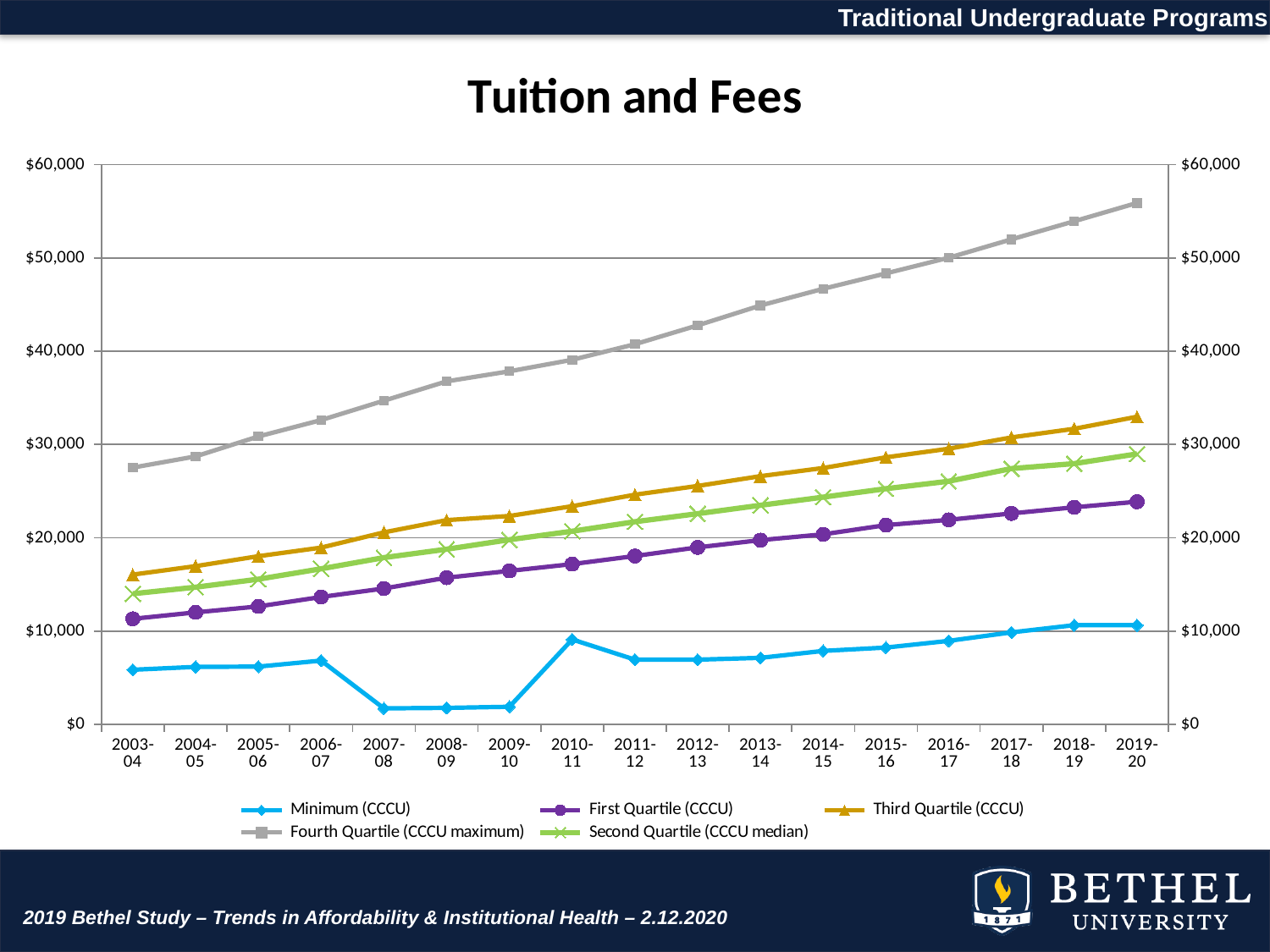
In 2003-04, which is larger: the Fourth Quartile (CCCU maximum) value or the Third Quartile (CCCU) value? Fourth Quartile (CCCU maximum) How many academic years are shown along the x axis? 17 What is the title of the chart? Tuition and Fees Is the Minimum (CCCU) value for 2007-08 greater or less than $5,000? less Is the Third Quartile (CCCU) value for 2019-20 greater or less than $30,000? greater Which series has the lowest value in 2019-20? Minimum (CCCU) Which series has the highest value in 2019-20? Fourth Quartile (CCCU maximum) What kind of chart is shown on the slide? line chart Does the Fourth Quartile (CCCU maximum) series rise or fall from 2003-04 to 2019-20? rise Is the Fourth Quartile (CCCU maximum) value for 2019-20 greater or less than $50,000? greater How many series does the legend list? 5